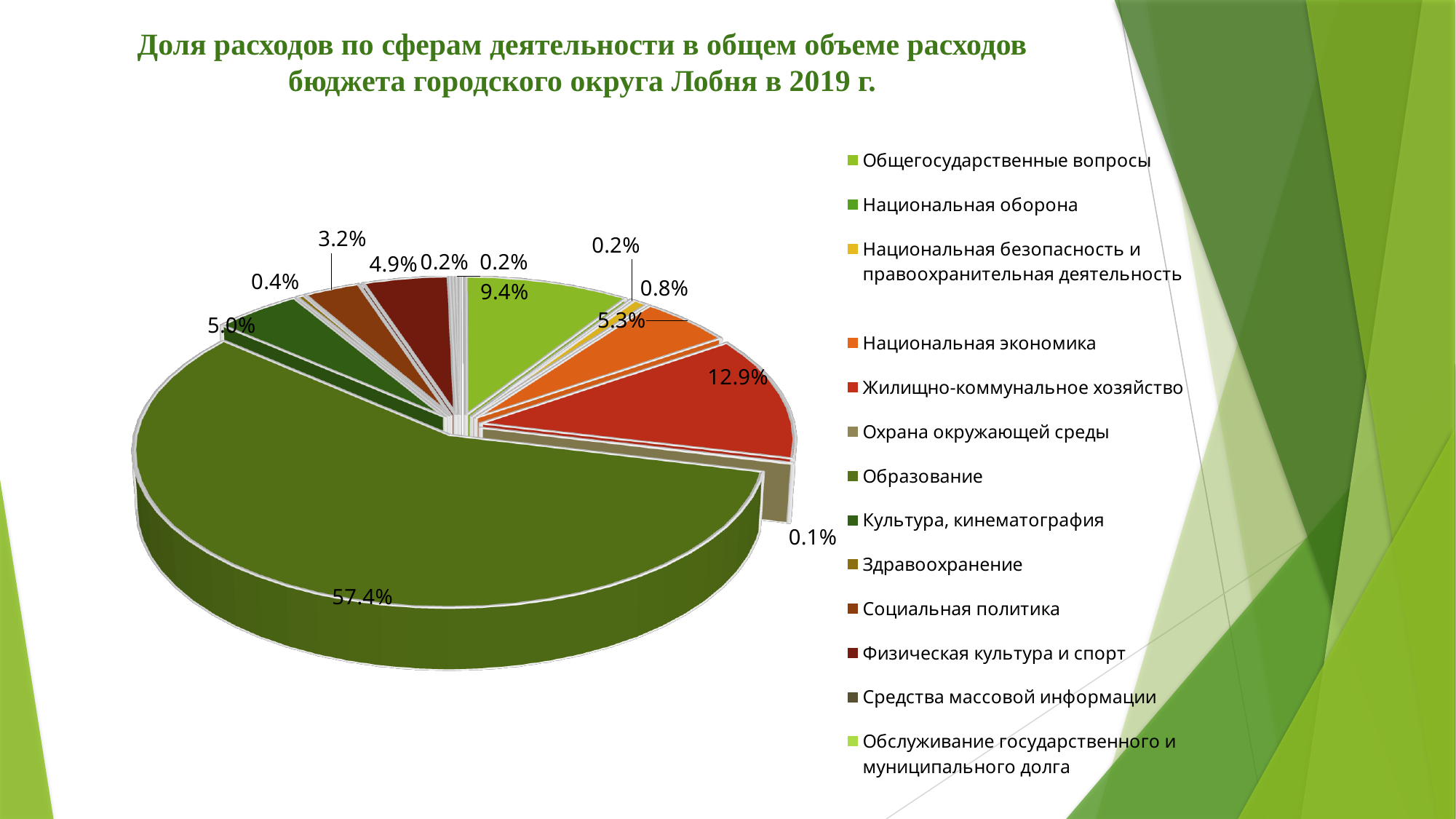
What share of expenditures does Образование account for? 57.4% What share of expenditures does Национальная экономика account for? 5.3% Which is larger, the share for Жилищно-коммунальное хозяйство or the share for Общегосударственные вопросы? Жилищно-коммунальное хозяйство What share of expenditures does Общегосударственные вопросы account for? 9.4% What is the title of the chart? Доля расходов по сферам деятельности в общем объеме расходов бюджета городского округа Лобня в 2019 г. What is the difference between the share for Общегосударственные вопросы and the share for Национальная экономика? 4.1% What type of chart is shown on the slide? pie chart What is the difference between the share for Образование and the share for Жилищно-коммунальное хозяйство? 44.5% Which category has the largest share of expenditures? Образование What share of expenditures does Социальная политика account for? 3.2% How many categories does the legend list? 13 What share of expenditures does Жилищно-коммунальное хозяйство account for? 12.9%